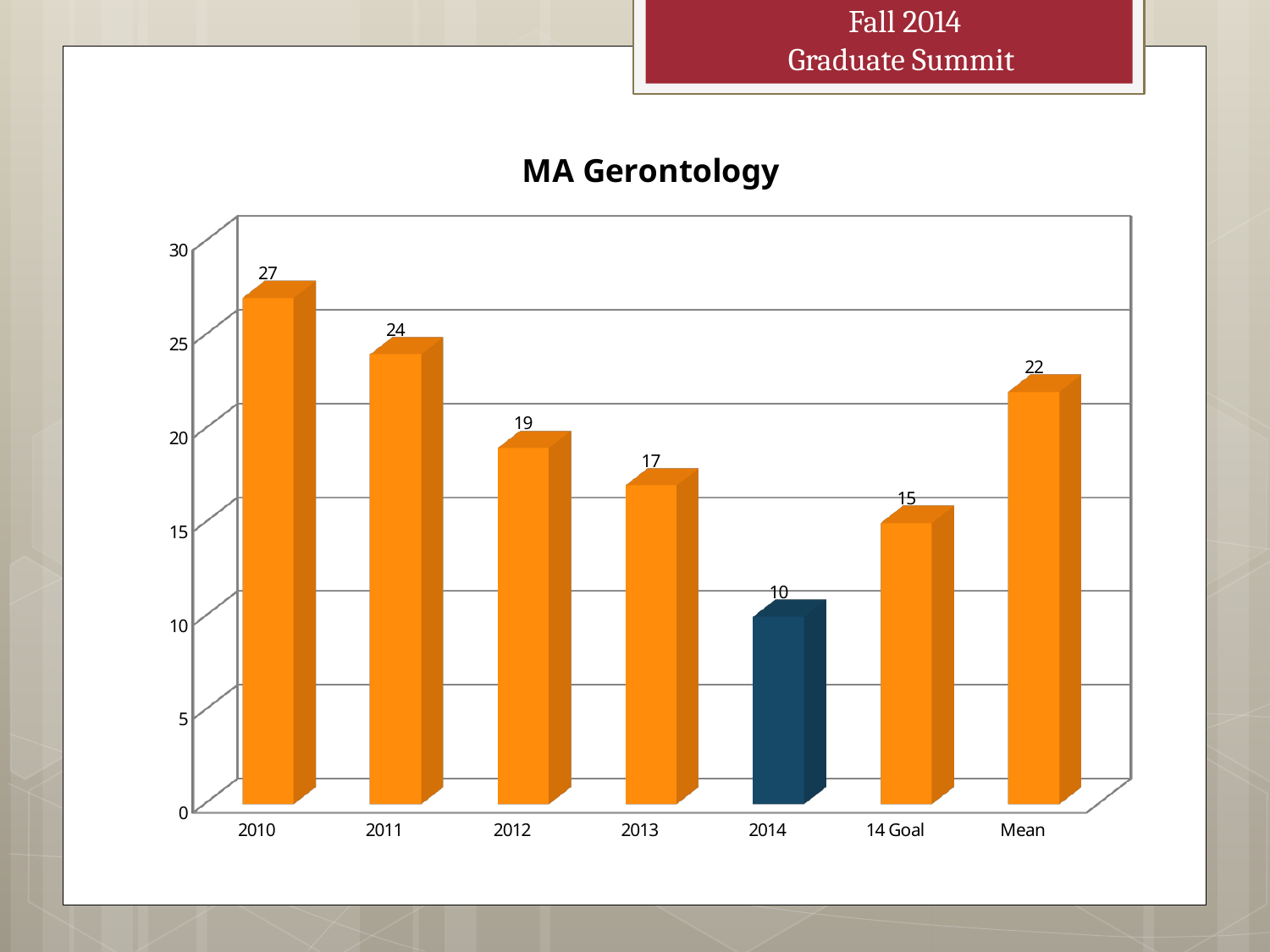
Which is larger, the value for 2012 or the value for Mean? Mean What is the value for 14 Goal? 15 Which category has the lowest value? 2014 What is the value for Mean? 22 What kind of chart is this? bar chart Do the values rise or fall from 2010 to 2014? fall What is the difference between the values for 2011 and 2013? 7 How many categories are shown on the x axis? 7 What is the difference between the 14 Goal value and the 2014 value? 5 What is the value for 2010? 27 What is the value for 2014? 10 Which category has the highest value? 2010